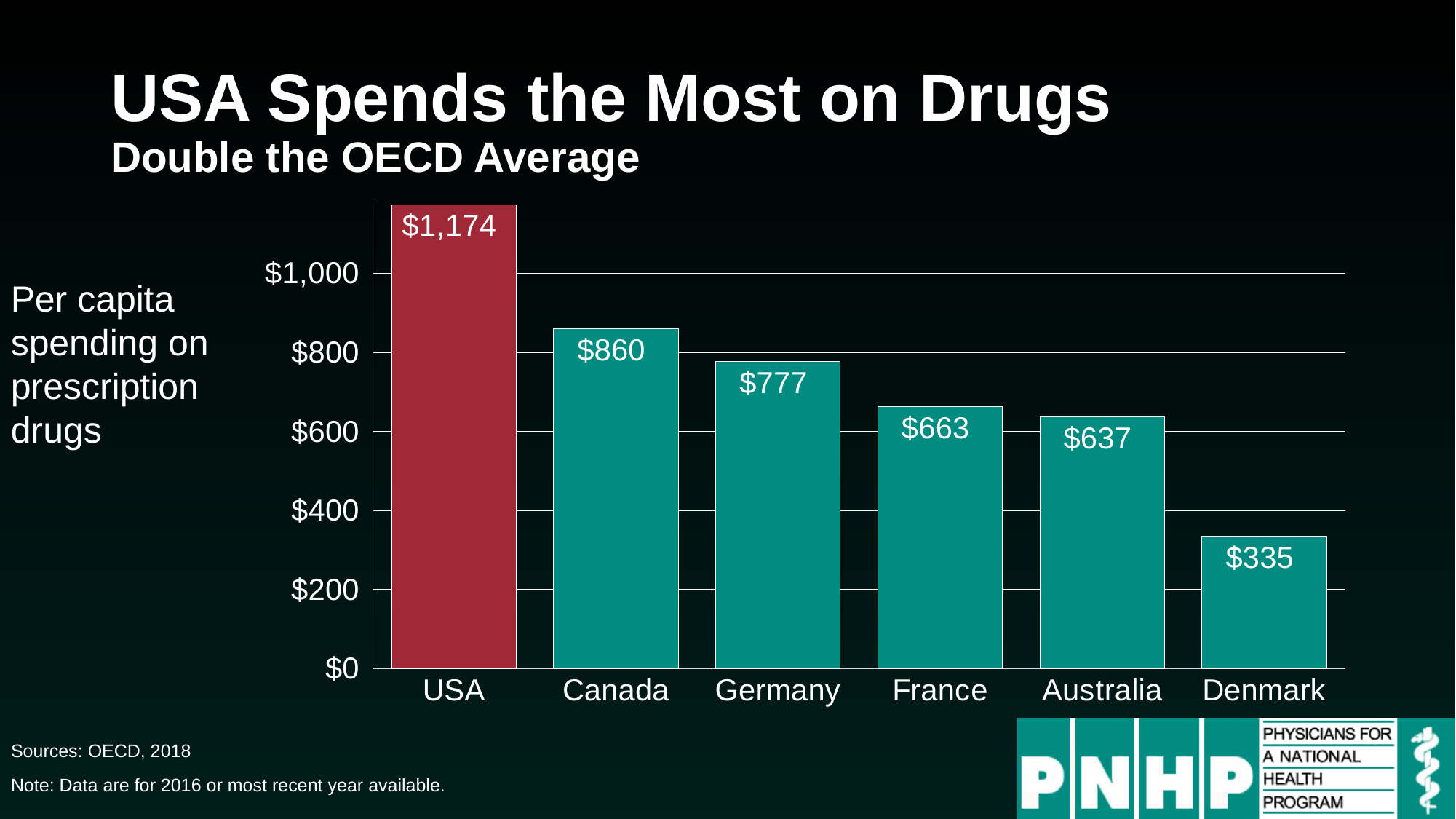
Is the value for Australia greater or less than $600? greater What is the per capita spending on prescription drugs for Germany? $777 What is the per capita spending on prescription drugs for the USA? $1,174 How many countries are shown in the chart? 6 What is the difference in per capita prescription drug spending between France and Australia? $26 Which bar is shown in a different colour (red) from the others? USA What is the difference in per capita prescription drug spending between the USA and Canada? $314 Which country has the lowest per capita spending on prescription drugs? Denmark Which country spends more per capita on prescription drugs, Canada or Germany? Canada What is the per capita spending on prescription drugs for Denmark? $335 Which country has the highest per capita spending on prescription drugs? USA What kind of chart is shown on the slide? Bar chart